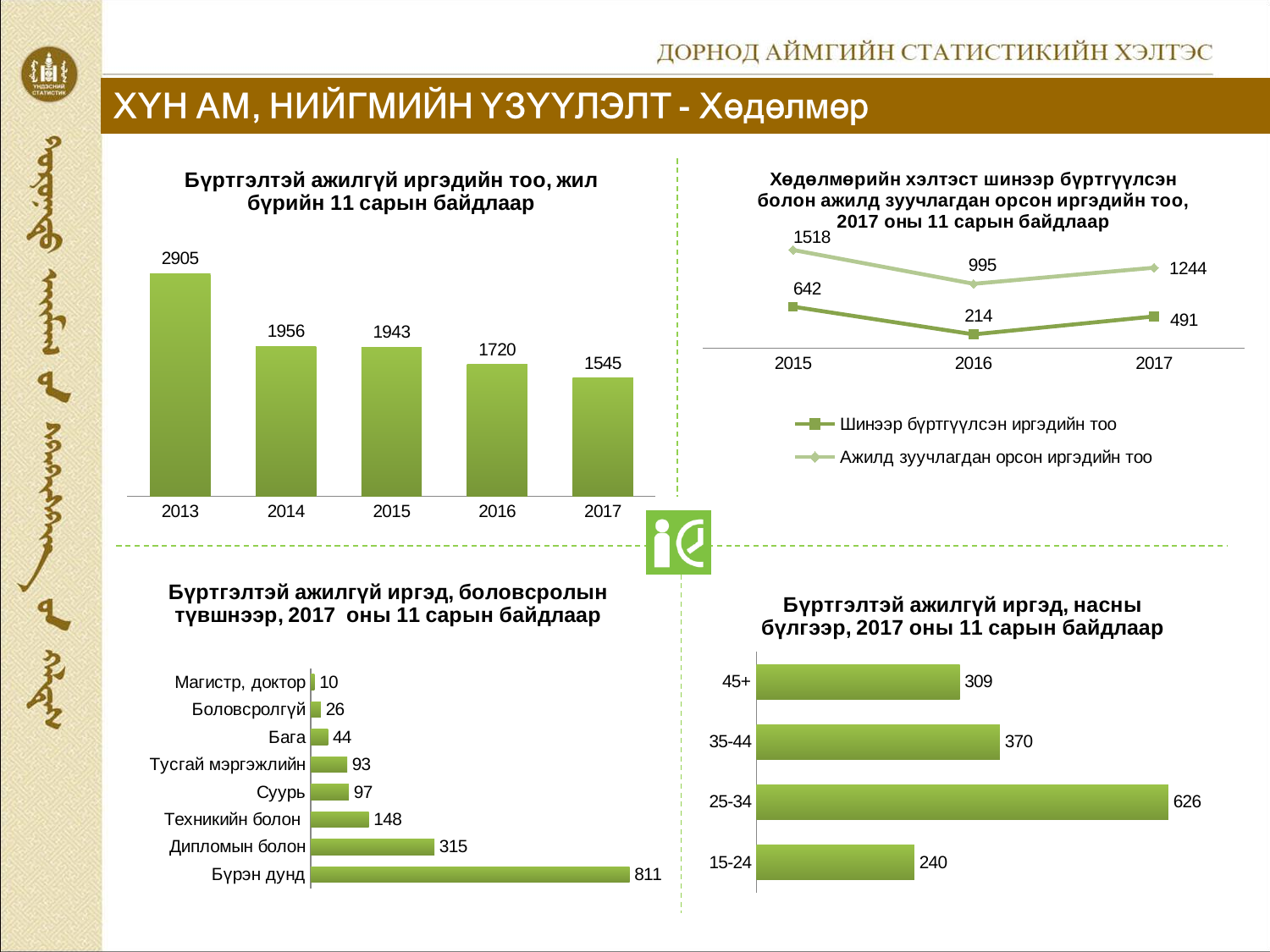
In the top-right line chart, how many series does the legend list? 2 In the top-left chart (Бүртгэлтэй ажилгүй иргэдийн тоо), which year has the lowest value? 2017 In the bottom-left chart (боловсролын түвшнээр), what is the value for Дипломын болон? 315 In the top-left chart (Бүртгэлтэй ажилгүй иргэдийн тоо), do the values rise or fall from 2013 to 2017? fall In the bottom-left chart (боловсролын түвшнээр), how many categories are shown? 8 In the top-right line chart, what is the value of Ажилд зуучлагдан орсон иргэдийн тоо for 2016? 995 In the top-left chart (Бүртгэлтэй ажилгүй иргэдийн тоо), what is the difference between the values for 2013 and 2014? 949 In the top-right line chart, which year has the lowest value for Шинээр бүртгүүлсэн иргэдийн тоо? 2016 In the bottom-right chart (насны бүлгээр), which age group has the highest value? 25-34 In the top-right line chart, what is the value of Шинээр бүртгүүлсэн иргэдийн тоо for 2017? 491 In the top-left chart (Бүртгэлтэй ажилгүй иргэдийн тоо), what is the value for 2013? 2905 In the bottom-right chart (насны бүлгээр), which is larger: the value for 35-44 or the value for 45+? 35-44